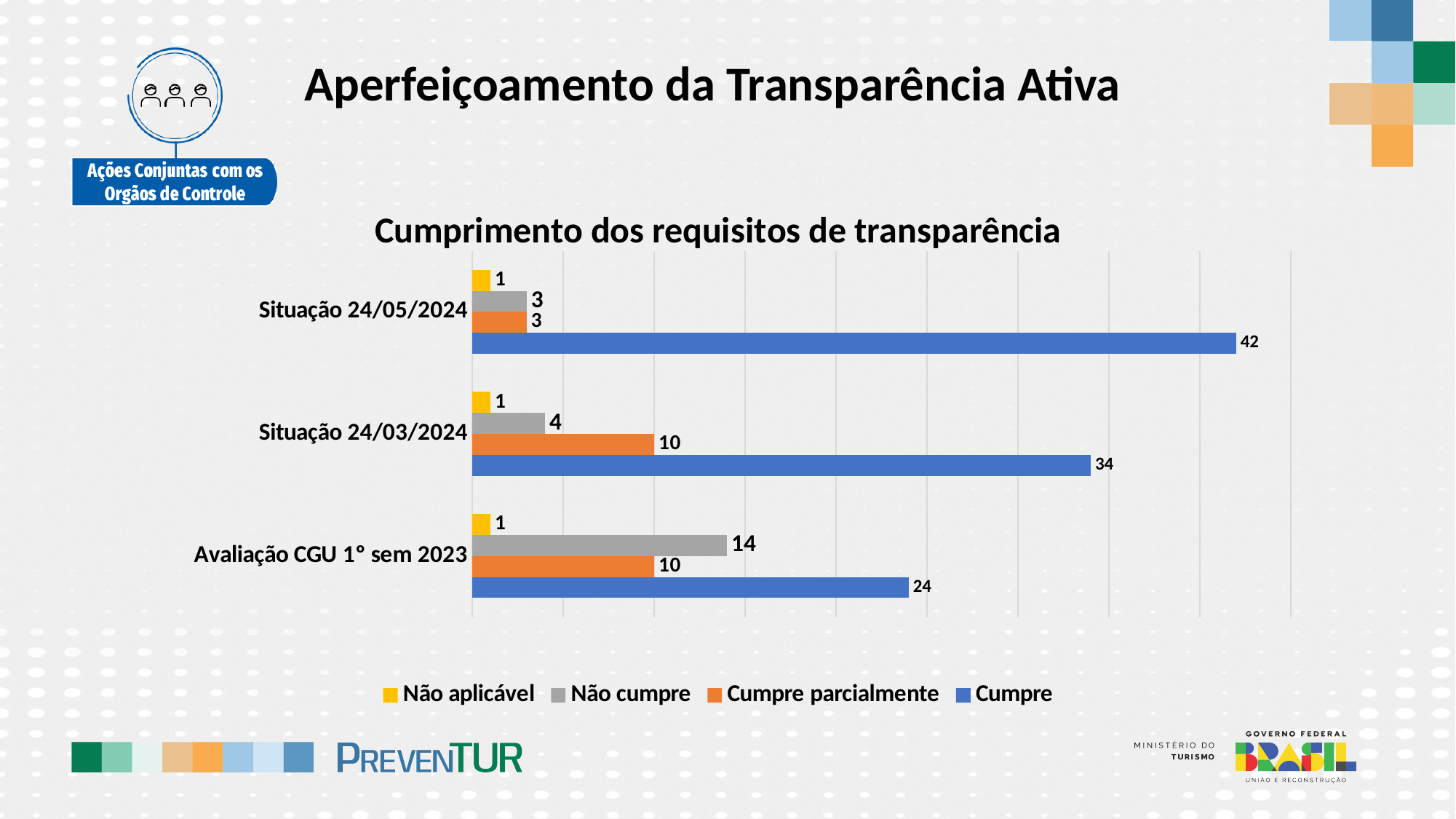
Which is larger: "Cumpre parcialmente" for Situação 24/03/2024 or for Situação 24/05/2024? Situação 24/03/2024 What is the value of "Cumpre" for Situação 24/05/2024? 42 What kind of chart is shown? Bar chart What is the value of "Cumpre parcialmente" for Situação 24/03/2024? 10 What is the value of "Não cumpre" for Avaliação CGU 1° sem 2023? 14 Which colour represents the "Não aplicável" series? Yellow How many categories are shown on the chart? 3 How many series does the legend list? 4 What is the difference between the "Cumpre" values for Situação 24/05/2024 and Avaliação CGU 1° sem 2023? 18 Which category has the highest value for "Cumpre"? Situação 24/05/2024 What is the title of the chart? Cumprimento dos requisitos de transparência Which category has the lowest value for "Não cumpre"? Situação 24/05/2024